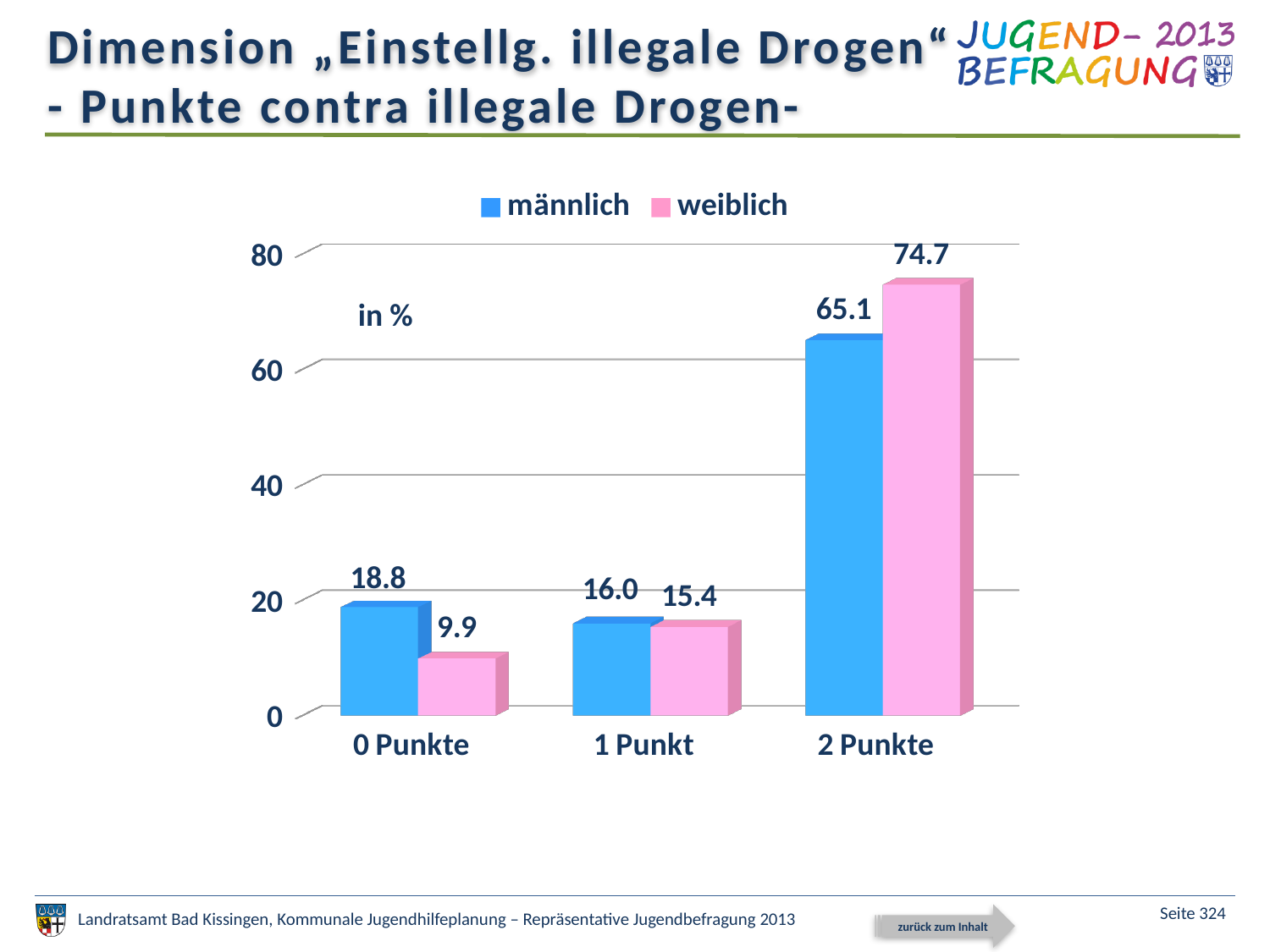
What is the value for weiblich at 2 Punkte? 74.7 What kind of chart is shown on the slide? bar chart Is the value for weiblich at 2 Punkte greater or less than 60? greater Which category has the highest value for männlich? 2 Punkte What is the difference between männlich and weiblich at 0 Punkte? 8.9 Which is larger at 0 Punkte, männlich or weiblich? männlich Which category has the lowest value for weiblich? 0 Punkte How many series does the legend list? 2 What is the value for männlich at 0 Punkte? 18.8 How many categories are shown on the x axis? 3 What is the value for weiblich at 1 Punkt? 15.4 What is the difference between weiblich and männlich at 2 Punkte? 9.6